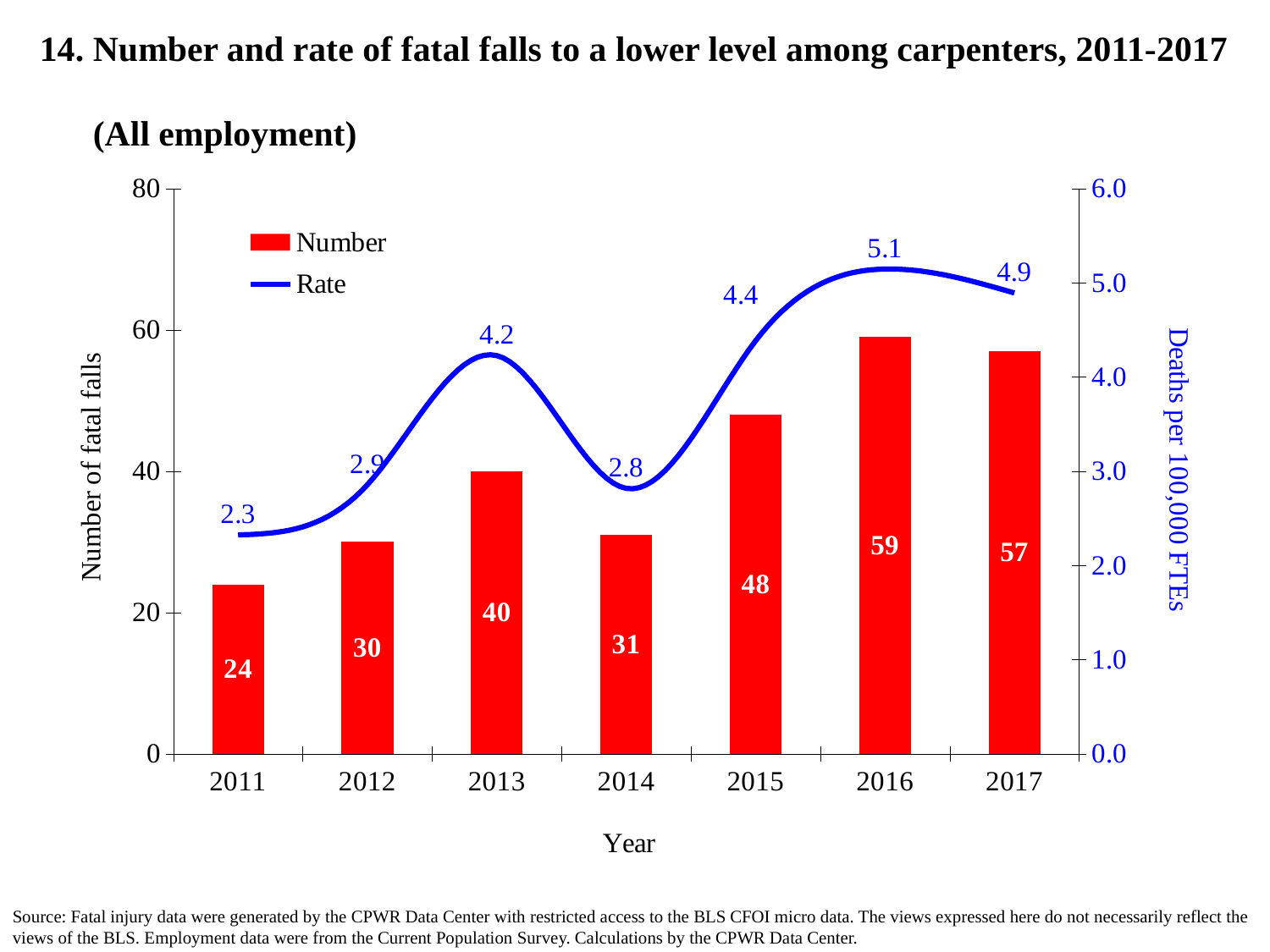
Which year has a higher number of fatal falls, 2013 or 2014? 2013 What kind of chart is used to show the Number series? Bar chart What is the difference in the number of fatal falls between 2016 and 2011? 35 Which year has the lowest rate of fatal falls? 2011 What is the difference in the rate of fatal falls between 2016 and 2014? 2.3 How many series does the legend list? 2 What is the rate of fatal falls in 2011? 2.3 What is the label of the right-hand vertical axis? Deaths per 100,000 FTEs What is the number of fatal falls among carpenters in 2016? 59 Which year has the highest number of fatal falls? 2016 How many years are shown on the x axis of the chart? 7 What is the rate of fatal falls (deaths per 100,000 FTEs) in 2013? 4.2